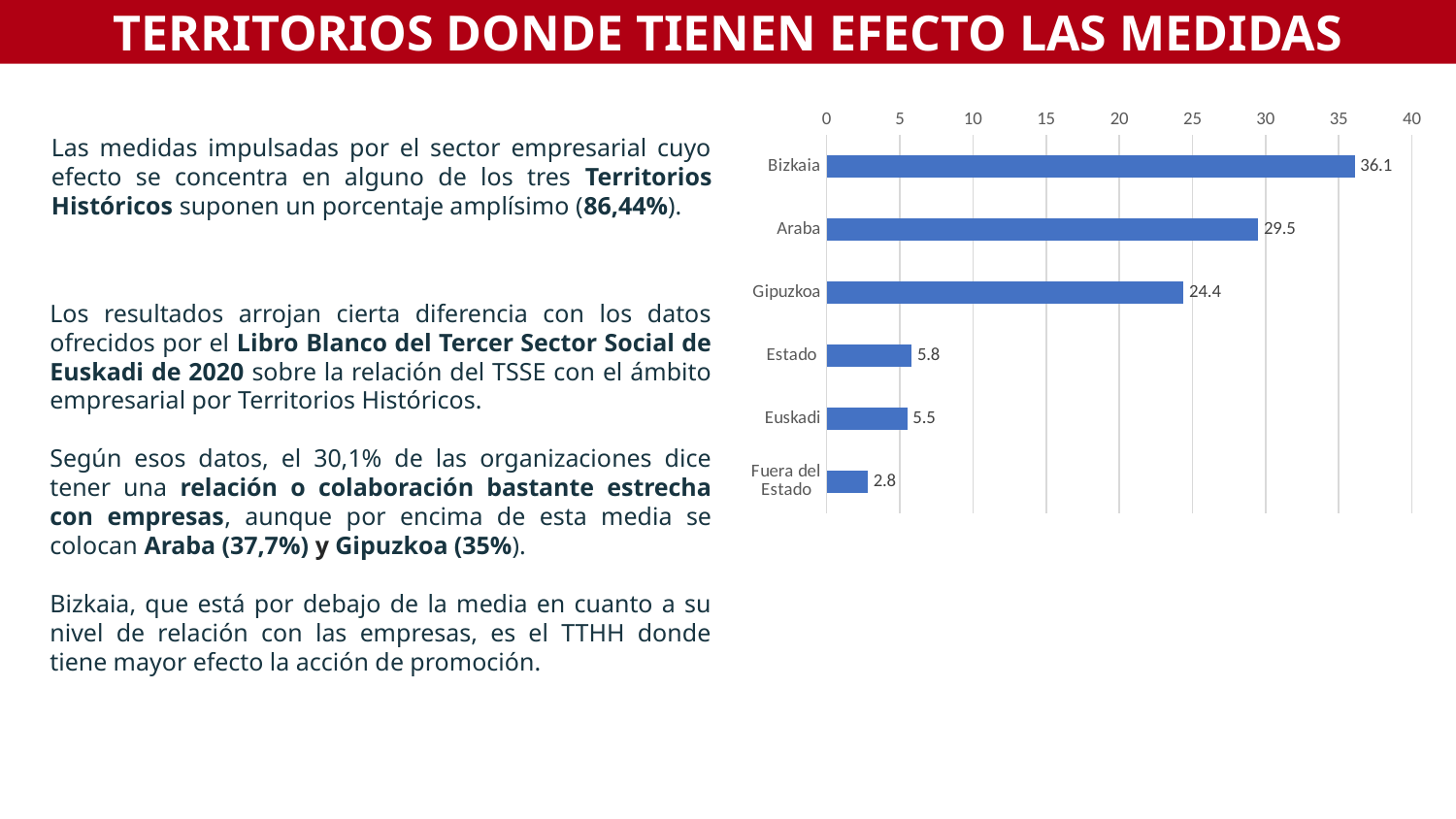
What is the total of the values for Bizkaia, Araba and Gipuzkoa? 90 What kind of chart is shown on the slide? Bar chart What is the maximum value shown on the chart's axis? 40 What is the value for Gipuzkoa? 24.4 What is the value for Fuera del Estado? 2.8 What is the difference between the values for Bizkaia and Araba? 6.6 What is the value for Bizkaia? 36.1 How many categories are shown in the chart? 6 Which is larger, the value for Estado or the value for Euskadi? Estado Which category has the lowest value? Fuera del Estado Is the value for Araba greater or less than 25? greater Which category has the highest value? Bizkaia